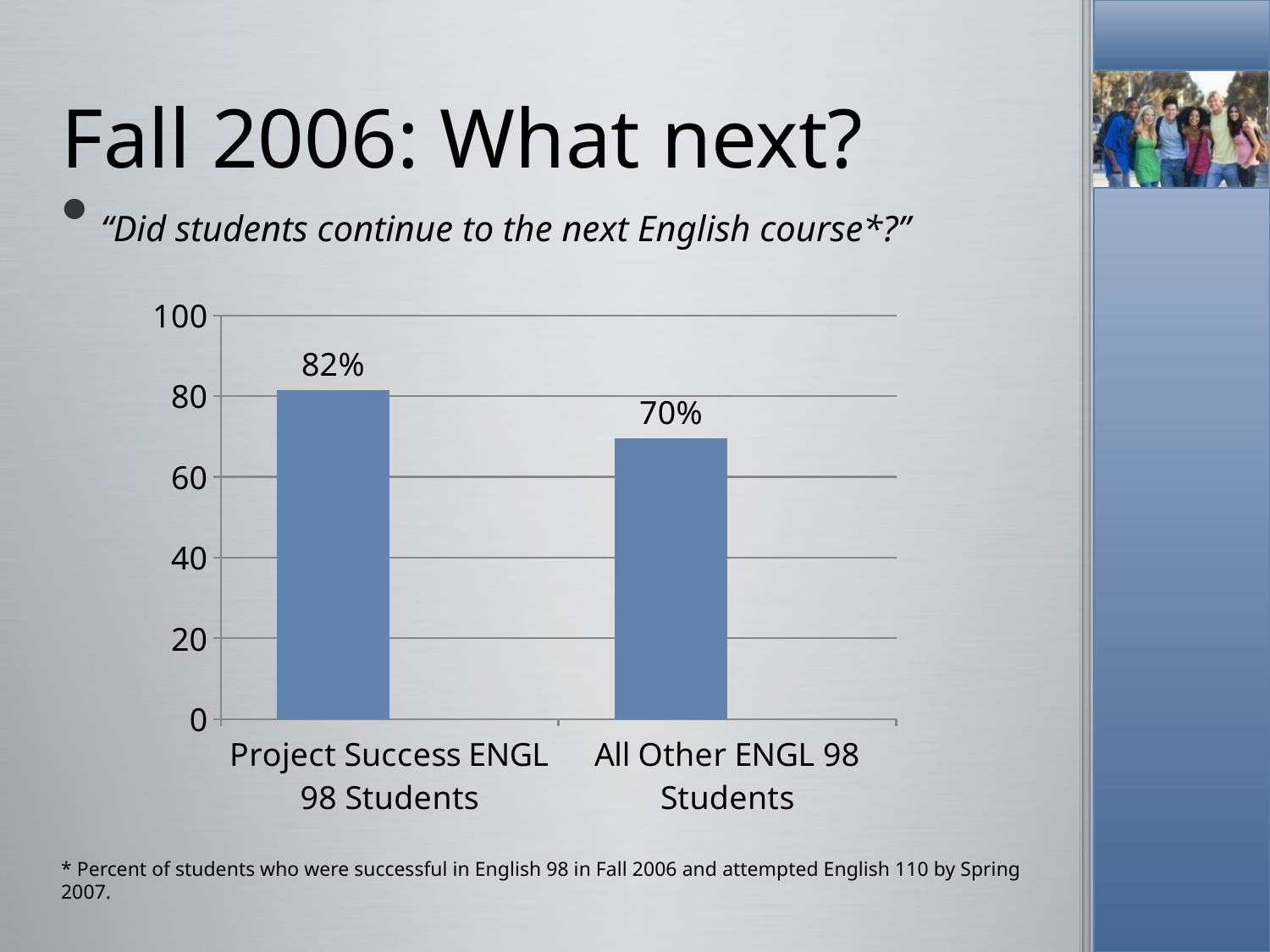
Is the value for Project Success ENGL 98 Students greater or less than 80? greater Which is larger, the value for Project Success ENGL 98 Students or the value for All Other ENGL 98 Students? Project Success ENGL 98 Students What is the difference between the values for Project Success ENGL 98 Students and All Other ENGL 98 Students? 12% What kind of chart is shown on the slide? Bar chart What is the value for Project Success ENGL 98 Students? 82% What is the highest value shown on the vertical axis? 100 Which category has the lowest value? All Other ENGL 98 Students How many categories are shown in the chart? 2 Is the value for All Other ENGL 98 Students greater or less than 80? less What is the title of the slide containing the chart? Fall 2006: What next? What is the value for All Other ENGL 98 Students? 70% Which category has the highest value? Project Success ENGL 98 Students